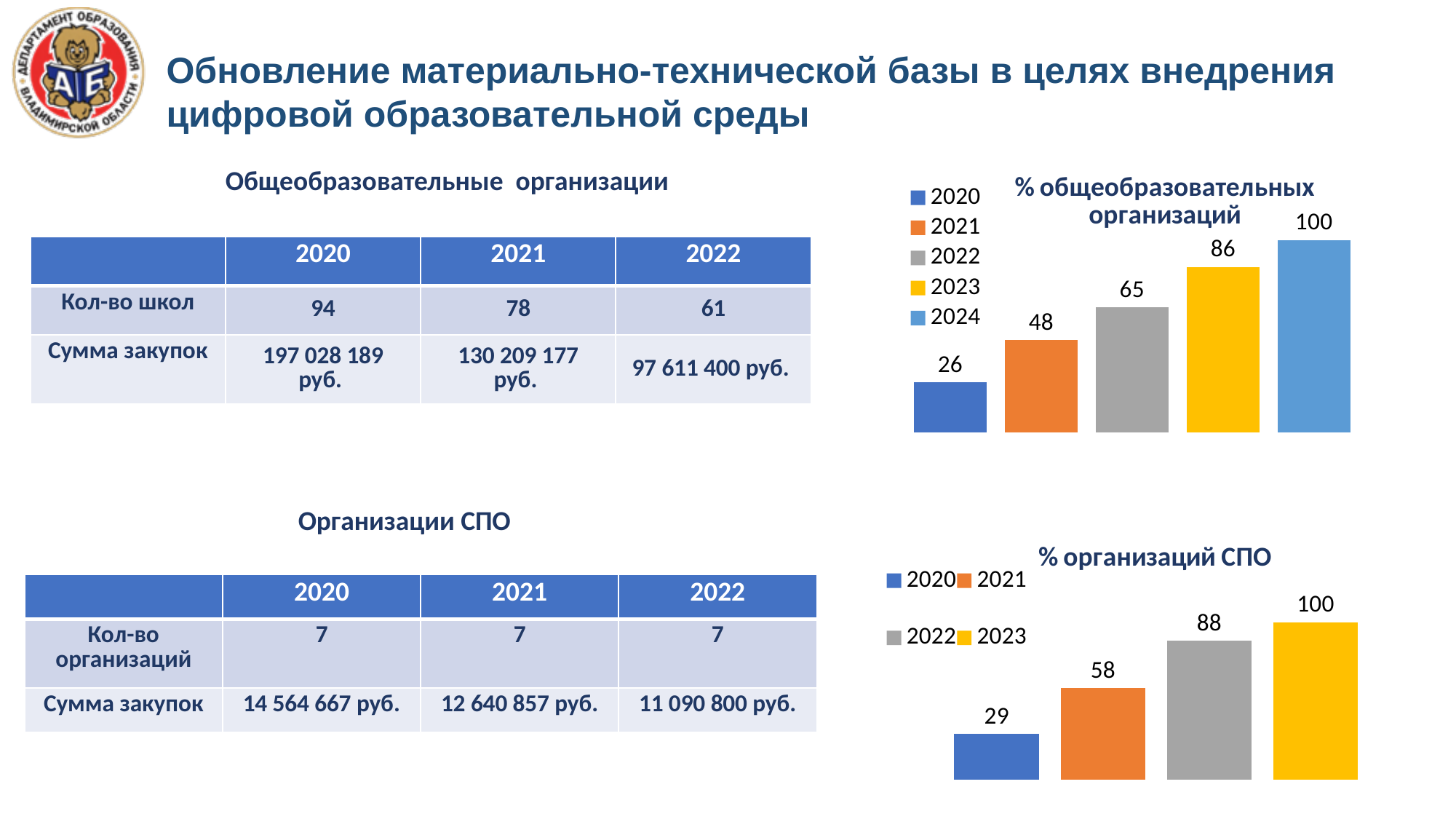
In the chart titled "% общеобразовательных организаций", how many bars are plotted? 5 In the chart titled "% общеобразовательных организаций", which year has the highest value? 2024 In the chart titled "% общеобразовательных организаций", do the values rise or fall from 2020 to 2024? rise In the chart titled "% организаций СПО", which year has the lowest value? 2020 In the chart titled "% организаций СПО", how many entries does the legend list? 4 In the chart titled "% общеобразовательных организаций", what is the value for 2020? 26 In the chart titled "% общеобразовательных организаций", what is the value for 2022? 65 What kind of chart is the one titled "% организаций СПО"? bar chart In the chart titled "% общеобразовательных организаций", what is the difference between the values for 2023 and 2021? 38 In the chart titled "% организаций СПО", what is the difference between the values for 2022 and 2020? 59 In the chart titled "% организаций СПО", what is the value for 2021? 58 Which is larger: the 2022 value in the chart "% организаций СПО" or the 2022 value in the chart "% общеобразовательных организаций"? % организаций СПО